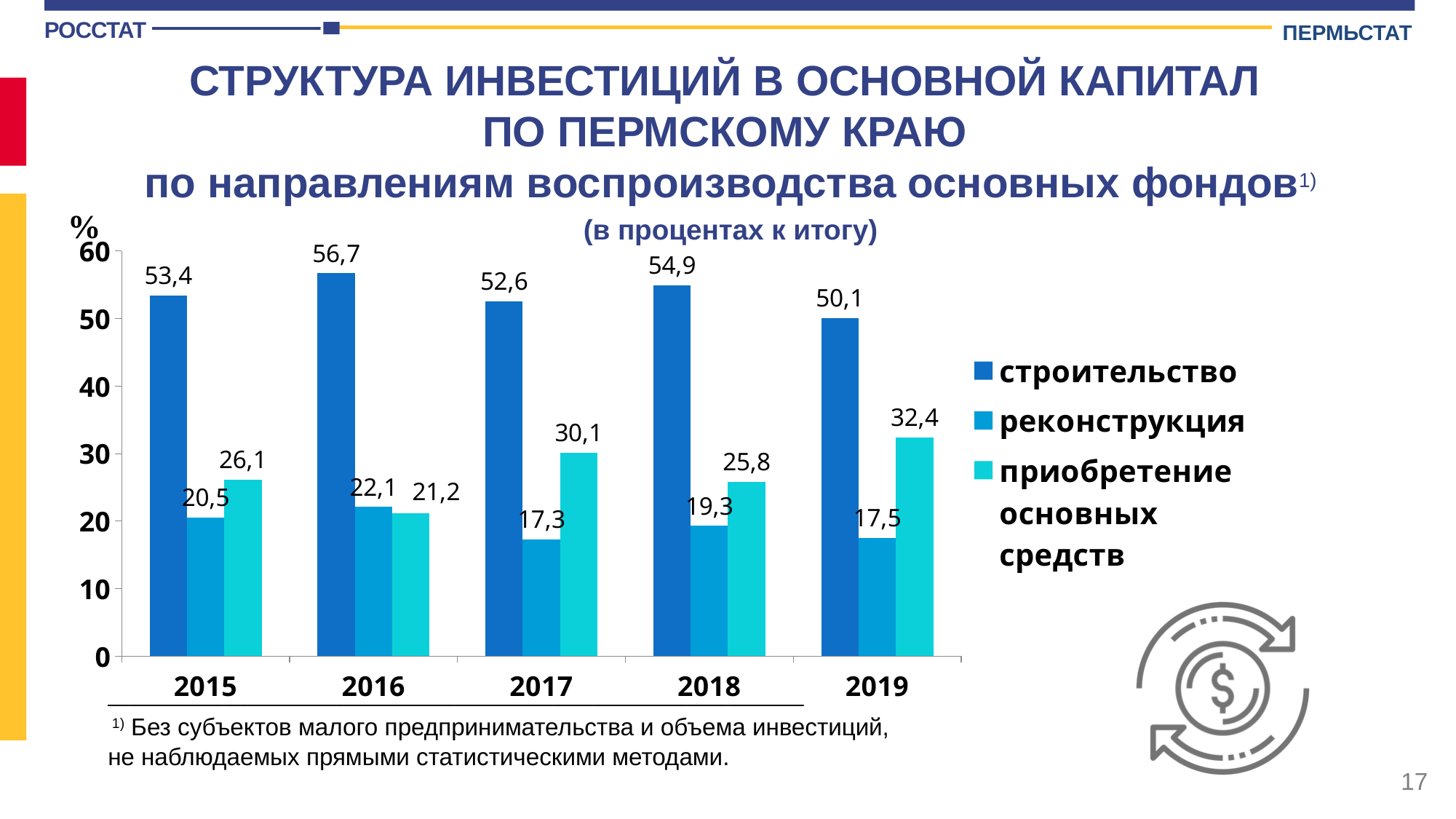
What is the value for приобретение основных средств in 2019? 32,4 What kind of chart is shown on the slide? bar chart How many years are shown on the x axis? 5 What is the difference between the строительство values in 2016 and 2019? 6,6 What unit is indicated at the top of the vertical axis? % Which is larger in 2017: реконструкция or приобретение основных средств? приобретение основных средств What is the value for реконструкция in 2018? 19,3 In which year is the value for строительство the highest? 2016 How many series does the legend list? 3 Is the value for приобретение основных средств in 2015 greater or less than 30? less In which year is the value for реконструкция the lowest? 2017 What is the value for строительство in 2016? 56,7